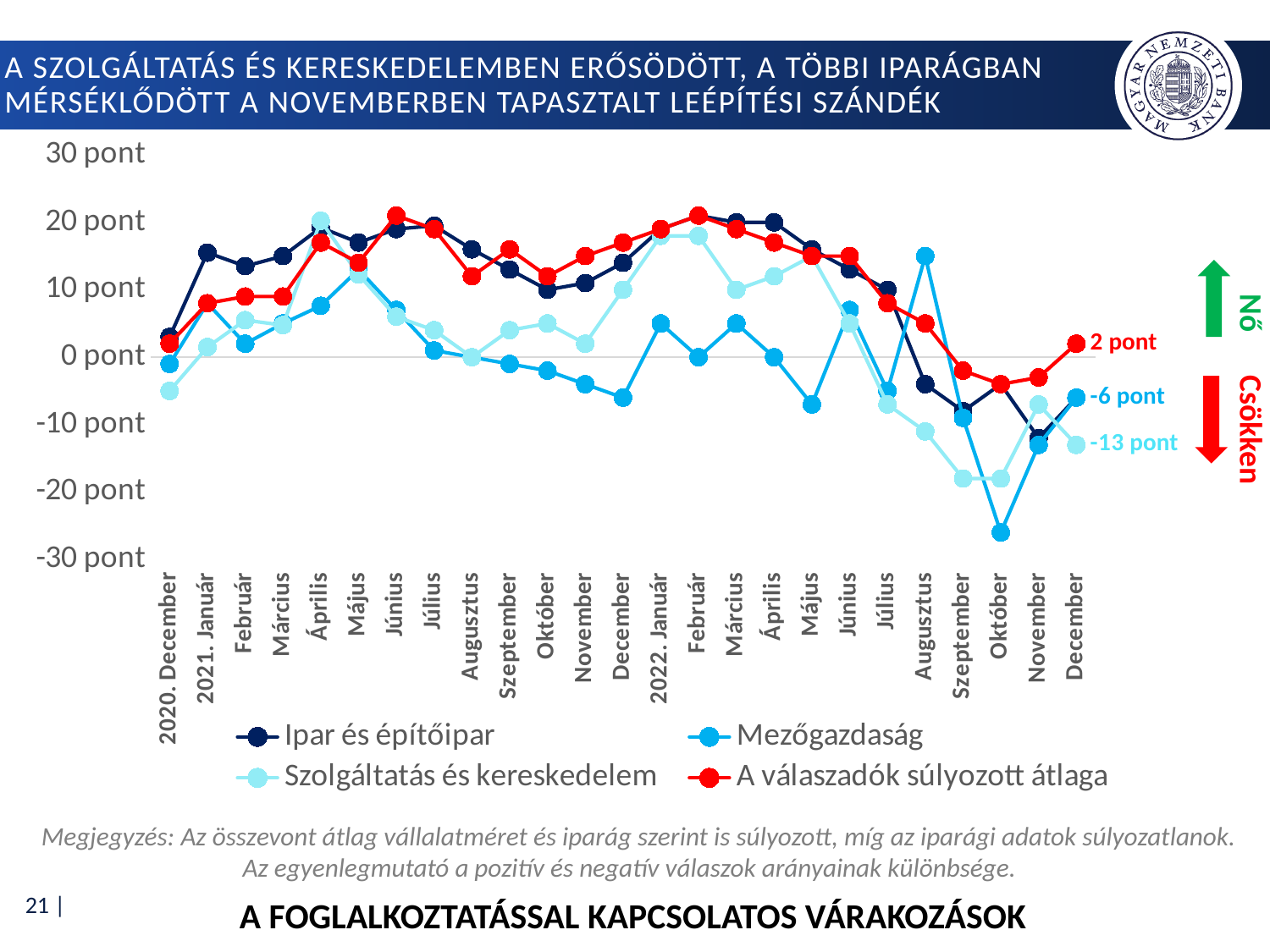
Does 'A válaszadók súlyozott átlaga' rise or fall from February 2022 to October 2022? fall What is the value of 'Szolgáltatás és kereskedelem' in December 2022? -13 pont Which series has the lowest value in October 2022? Mezőgazdaság What is the difference between 'A válaszadók súlyozott átlaga' and 'Szolgáltatás és kereskedelem' in December 2022? 15 pont What kind of chart is shown on the slide? line chart In December 2022, which is larger: 'Mezőgazdaság' or 'Szolgáltatás és kereskedelem'? Mezőgazdaság What is the value of 'Mezőgazdaság' in December 2022? -6 pont What is the value of 'A válaszadók súlyozott átlaga' in December 2022? 2 pont Which series has the highest value in December 2022? A válaszadók súlyozott átlaga How many series does the legend list? 4 Is the value for 'Mezőgazdaság' in October 2022 greater or less than -20 pont? less Which series has the lowest value in December 2022? Szolgáltatás és kereskedelem